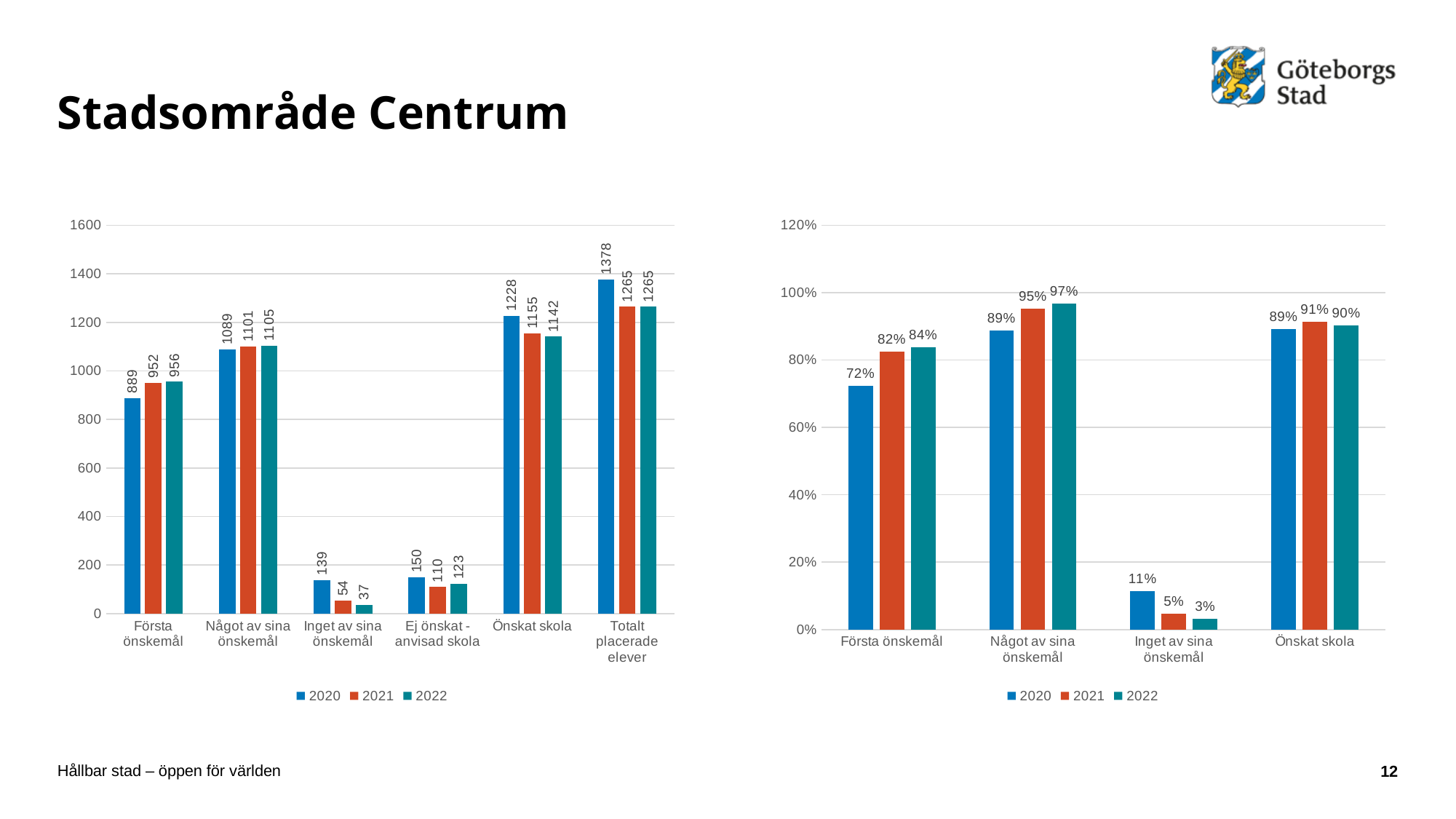
In the left chart, how many categories are shown on the x axis? 6 In the right chart, do the values for Första önskemål rise or fall from 2020 to 2022? rise In the left chart, what is the difference between the 2020 and 2022 values for Önskat skola? 86 In the left chart, what is the value for Inget av sina önskemål in 2021? 54 In the right chart, which is larger for Önskat skola: the 2021 value or the 2022 value? 2021 In the right chart, what is the value for Inget av sina önskemål in 2020? 11% In the right chart, what is the value for Något av sina önskemål in 2022? 97% In the left chart, what is the value for Totalt placerade elever in 2022? 1265 How many series does the legend of the right chart list? 3 In the left chart, which category has the highest value for 2020? Totalt placerade elever In the left chart, what is the value for Första önskemål in 2020? 889 In the left chart, which category has the lowest value for 2022? Inget av sina önskemål